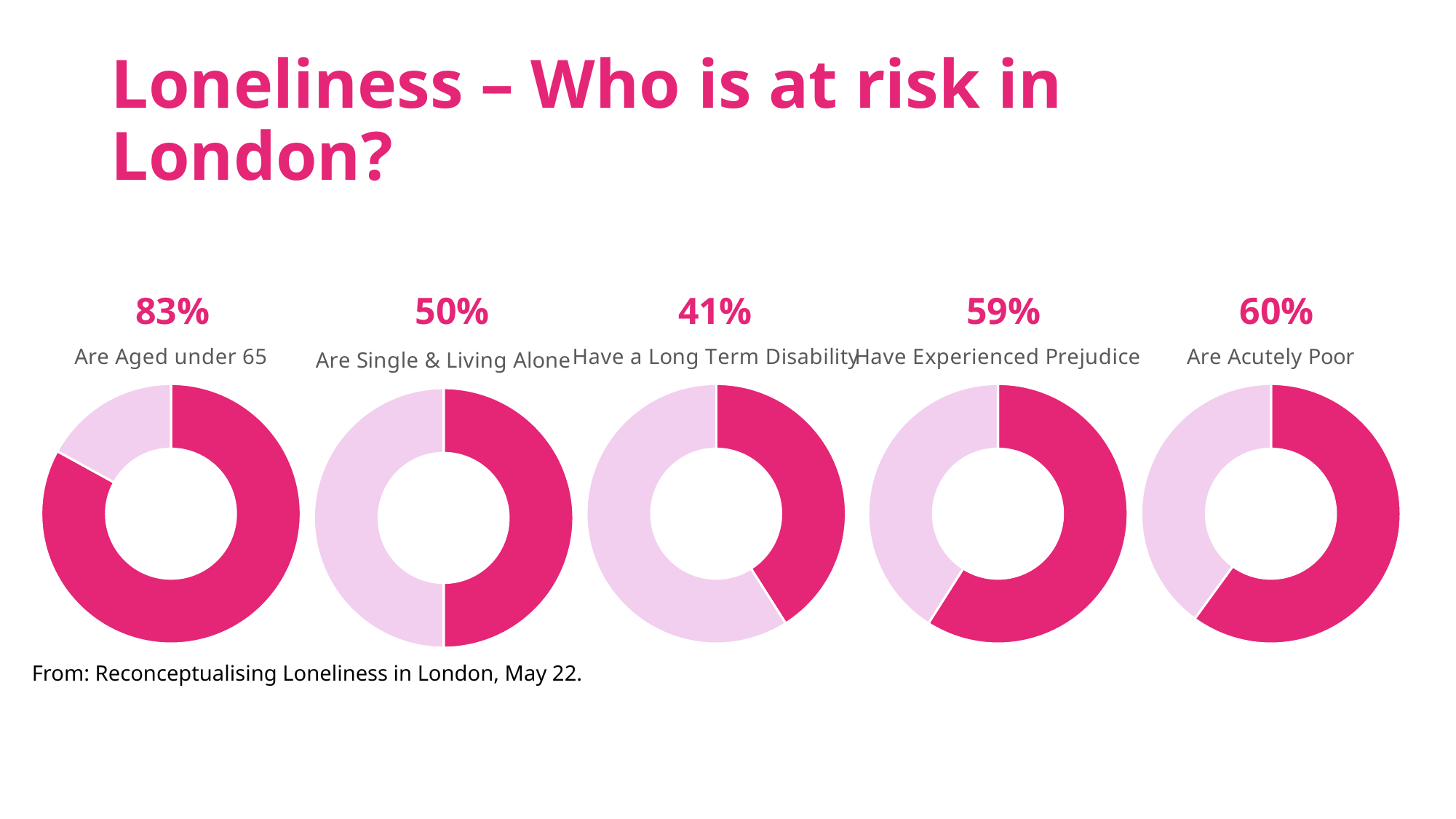
What percentage is shown for 'Are Acutely Poor'? 60% What percentage is shown for 'Are Single & Living Alone'? 50% What kind of chart is used to show each percentage? Donut (pie) chart What percentage is shown for 'Have a Long Term Disability'? 41% How many donut charts are shown on the slide? 5 Which group has the highest percentage shown? Are Aged under 65 What is the difference between the percentage for 'Are Aged under 65' and 'Are Single & Living Alone'? 33% What percentage is shown for 'Have Experienced Prejudice'? 59% Which group has the lowest percentage shown? Have a Long Term Disability What is the title of the slide? Loneliness – Who is at risk in London? What percentage is shown for 'Are Aged under 65'? 83% Which is larger: the percentage for 'Have Experienced Prejudice' or 'Have a Long Term Disability'? Have Experienced Prejudice